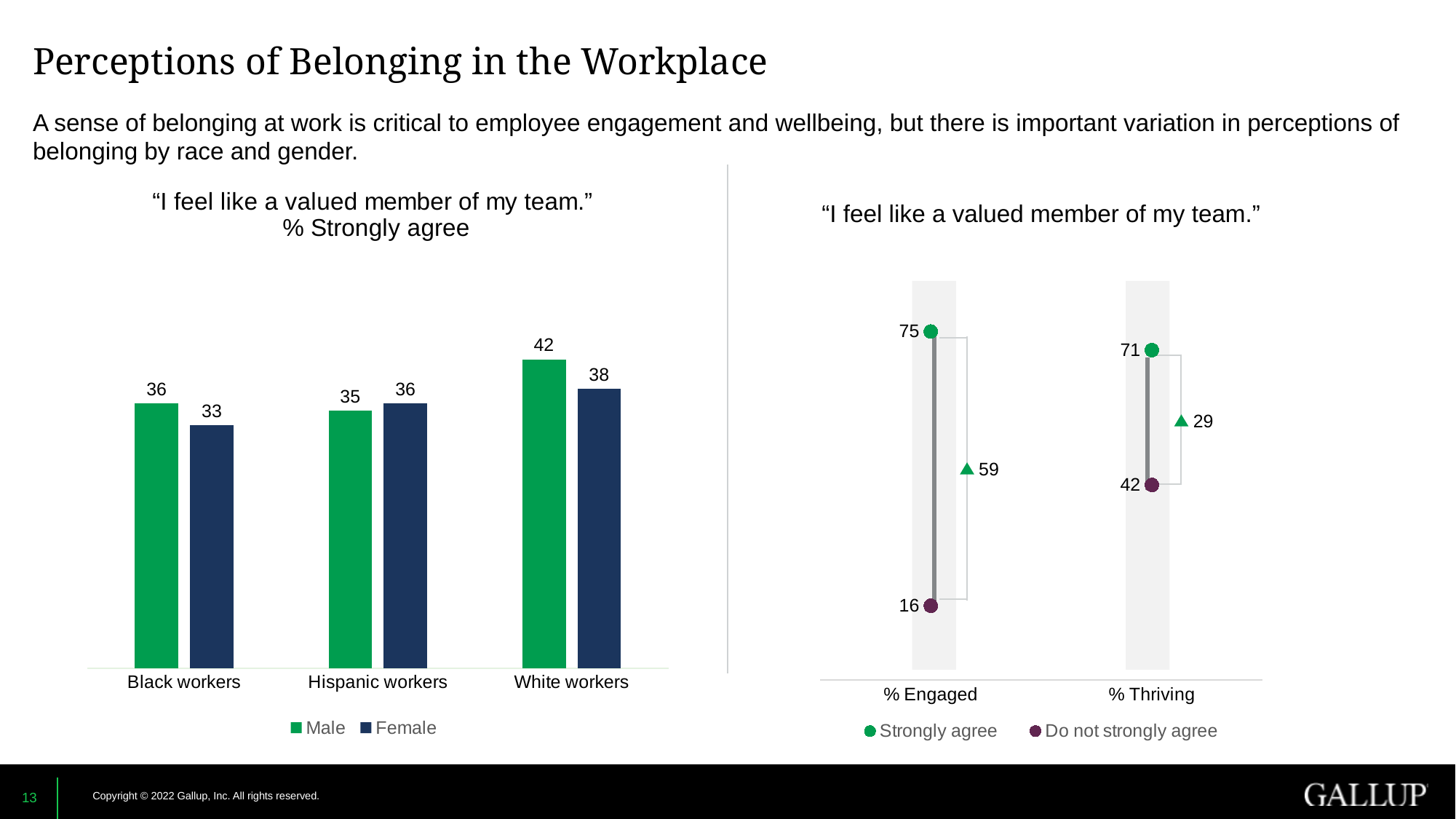
In the left chart (% Strongly agree), what is the value for Female among White workers? 38 In the left chart (% Strongly agree), what is the value for Male among Black workers? 36 In the right chart, what is the difference between Strongly agree and Do not strongly agree for % Engaged? 59 In the left chart (% Strongly agree), how many series does the legend list? 2 In the right chart, what is the % Engaged value for those who strongly agree? 75 In the right chart, what is the % Thriving value for those who do not strongly agree? 42 In the left chart (% Strongly agree), is the Male or Female value larger for Hispanic workers? Female In the left chart (% Strongly agree), how many worker groups are shown on the x axis? 3 In the left chart (% Strongly agree), which group has the highest Male value? White workers What kind of chart is the left chart (% Strongly agree)? Bar chart In the left chart (% Strongly agree), which group has the lowest Female value? Black workers In the left chart (% Strongly agree), what is the difference between the Male and Female values for White workers? 4